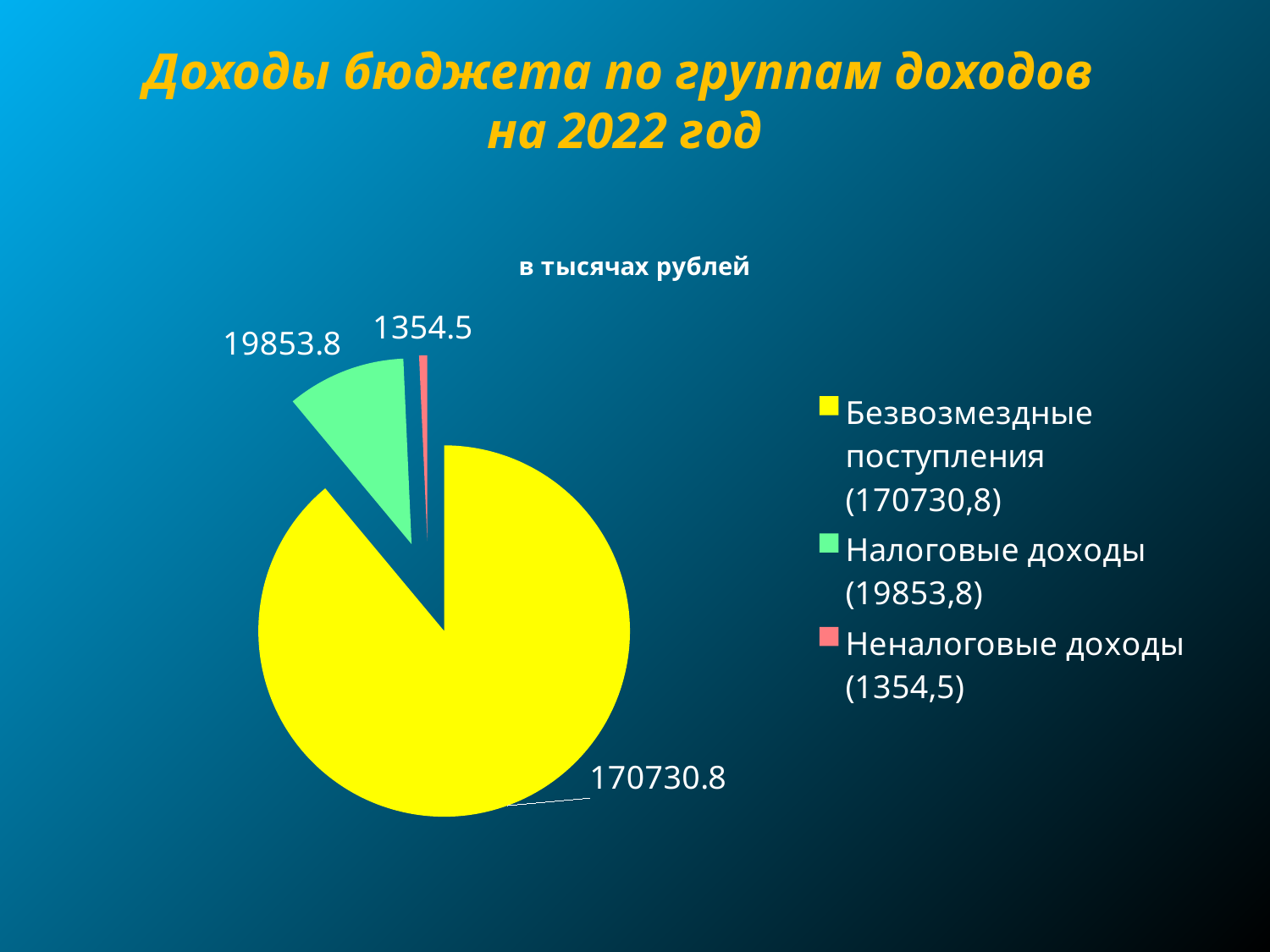
What type of chart is shown on the slide? pie chart Which category has the largest slice of the pie? Безвозмездные поступления What is the value for Неналоговые доходы? 1354.5 What is the difference between Безвозмездные поступления and Налоговые доходы? 150877.0 What is the value for Безвозмездные поступления? 170730.8 Which is larger, Налоговые доходы or Неналоговые доходы? Налоговые доходы What is the value for Налоговые доходы? 19853.8 What unit is stated in the chart title? в тысячах рублей How many entries does the legend list? 3 How many slices does the pie chart have? 3 Which category has the smallest slice of the pie? Неналоговые доходы